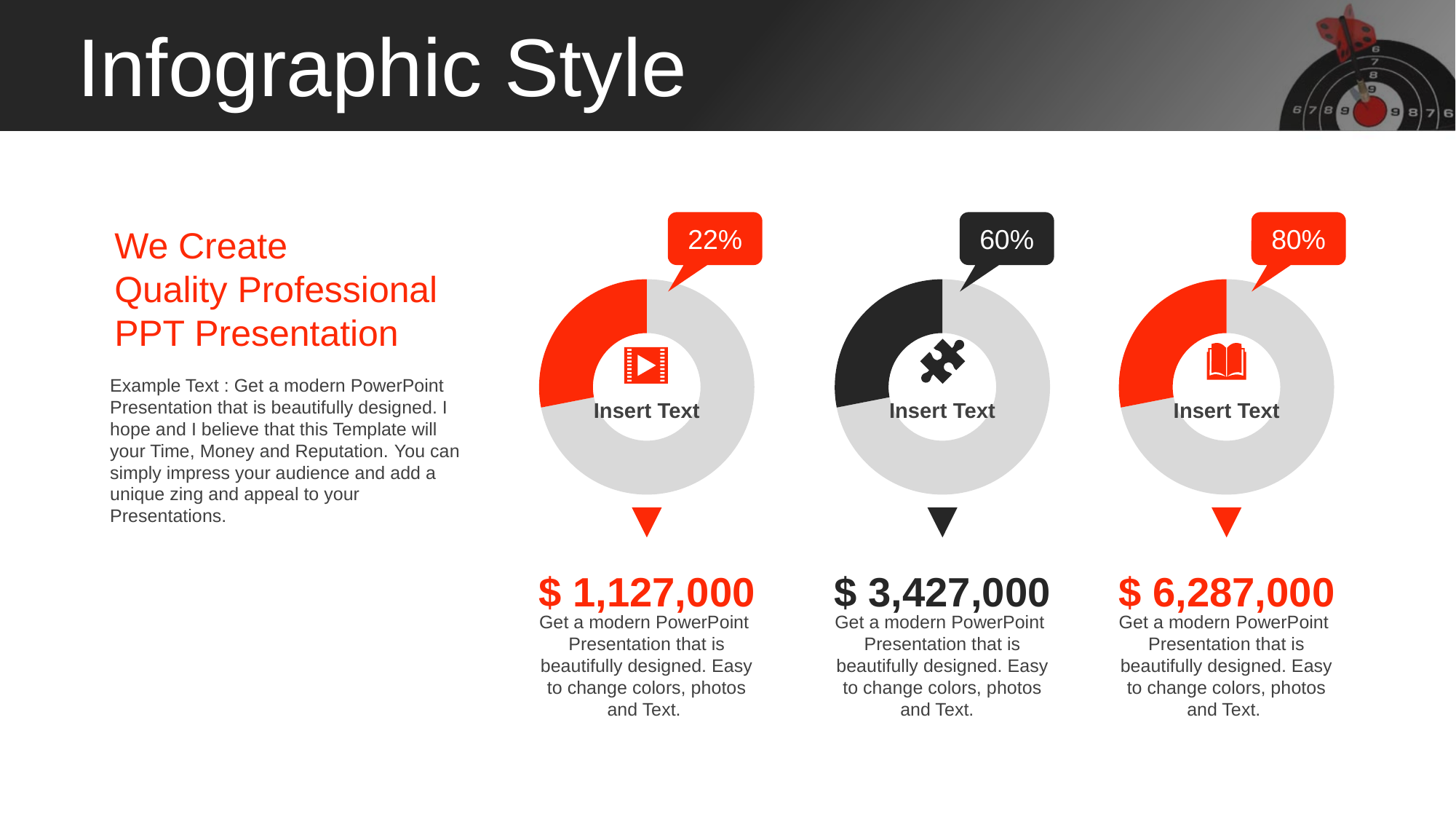
How many donut charts are on the slide? 3 What kind of chart is used for the three graphics on the slide? Donut (pie) chart What percentage is shown in the callout above the right donut chart? 80% What dollar amount is printed below the left donut chart? $ 1,127,000 What is the difference in percentage points between the right donut chart (80%) and the left donut chart (22%)? 58 percentage points Which of the three donut charts shows the lowest percentage? The left chart (22%) Which of the three donut charts shows the highest percentage? The right chart (80%) What is the difference in percentage points between the middle donut chart (60%) and the left donut chart (22%)? 38 percentage points What colour is the filled segment of the middle donut chart? Dark grey/black What percentage is shown in the callout above the left donut chart? 22% Which shows a larger percentage, the middle donut chart or the left donut chart? The middle chart (60%) What percentage is shown in the callout above the middle donut chart? 60%